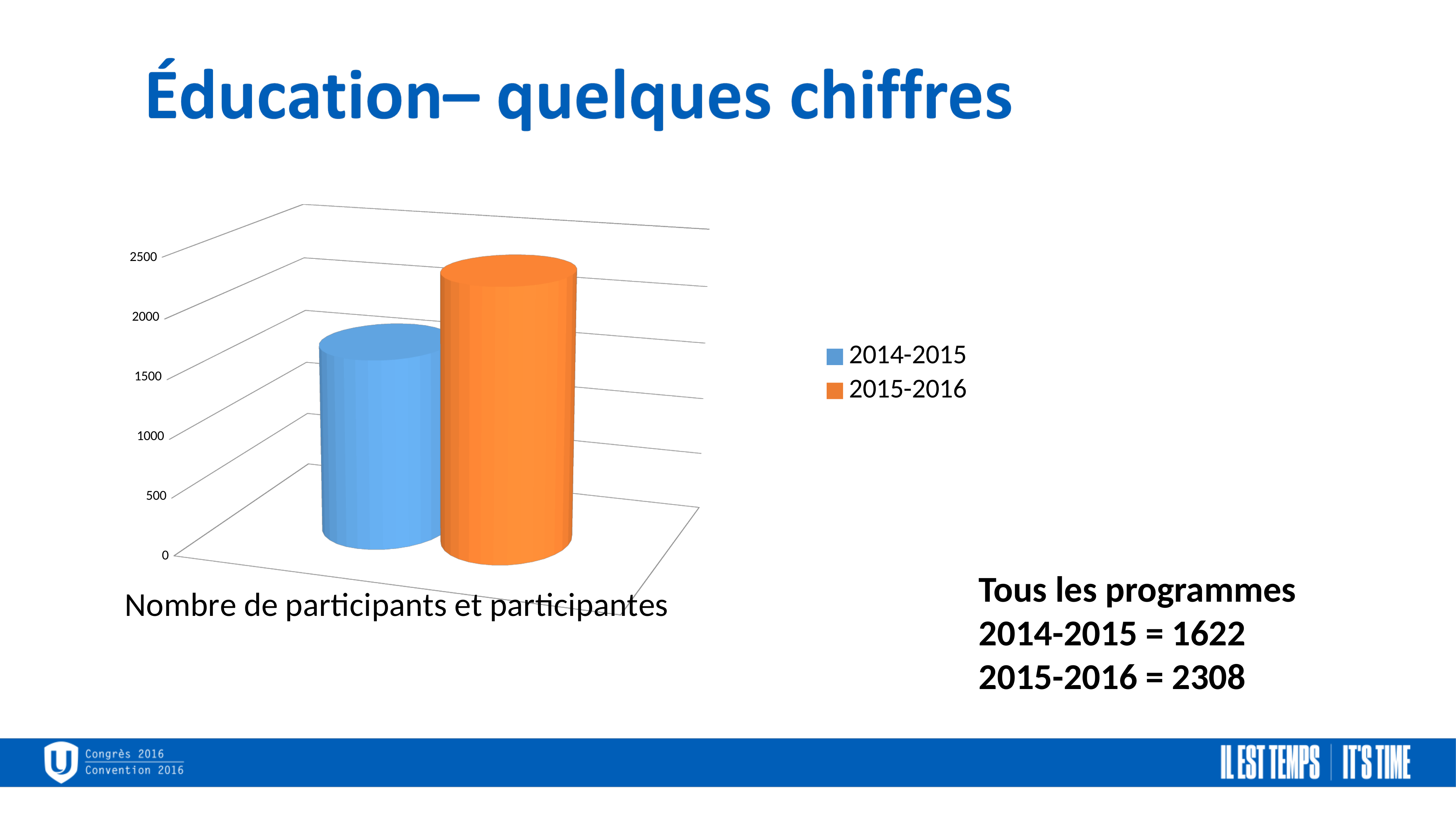
What is the number of participants for 2014-2015? 1622 What is the label on the category axis of the chart? Nombre de participants et participantes What kind of chart is shown on the slide? bar chart Is the value for 2014-2015 greater or less than 2000? less Is the value for 2015-2016 greater or less than 2000? greater Which series has the lowest value in the chart? 2014-2015 Which series has the higher value, 2014-2015 or 2015-2016? 2015-2016 Is the value for 2014-2015 greater or less than 1500? greater How many series does the chart legend list? 2 What is the difference between the 2015-2016 value and the 2014-2015 value? 686 What colour is the bar for the 2015-2016 series? orange What is the number of participants for 2015-2016? 2308